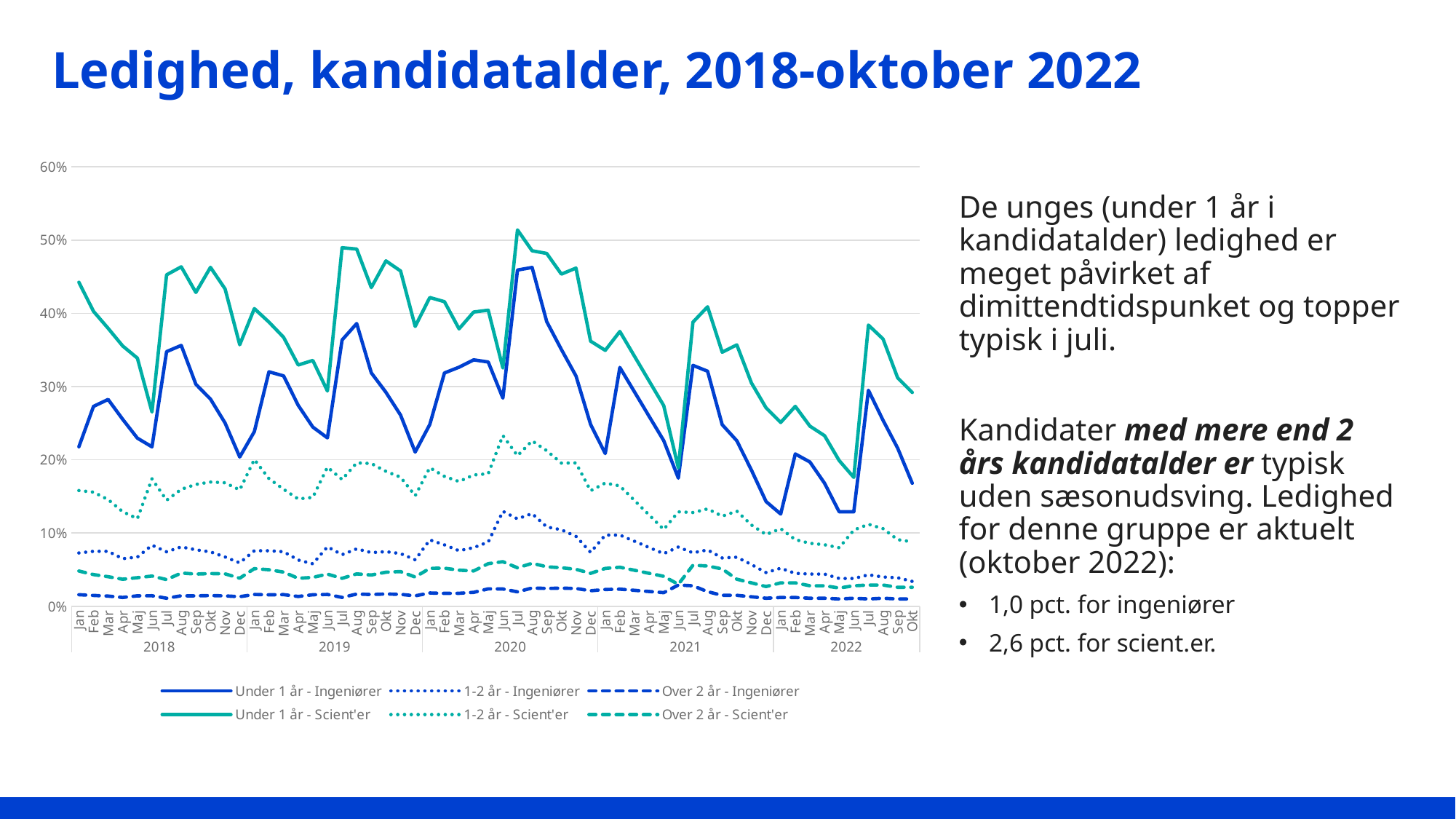
Does the Under 1 år - Scient'er line rise or fall from Jul 2022 to Okt 2022? fall In Jan 2018, which is larger: Under 1 år - Scient'er or Under 1 år - Ingeniører? Under 1 år - Scient'er What kind of chart is shown on the slide? line chart What is the title of the slide containing the chart? Ledighed, kandidatalder, 2018-oktober 2022 How many series does the chart legend list? 6 Is the value for Over 2 år - Ingeniører in Jan 2018 greater or less than 10%? less According to the slide, what is the unemployment rate for ingeniører with more than 2 years of kandidatalder in October 2022? 1,0 pct. How many years are labelled along the x axis of the chart? 5 Which series reaches the highest value anywhere on the chart? Under 1 år - Scient'er Which series stays lowest across the chart? Over 2 år - Ingeniører Is the value for Under 1 år - Ingeniører in Jul 2020 greater or less than 40%? greater Is the value for Under 1 år - Scient'er in Jul 2020 greater or less than 40%? greater